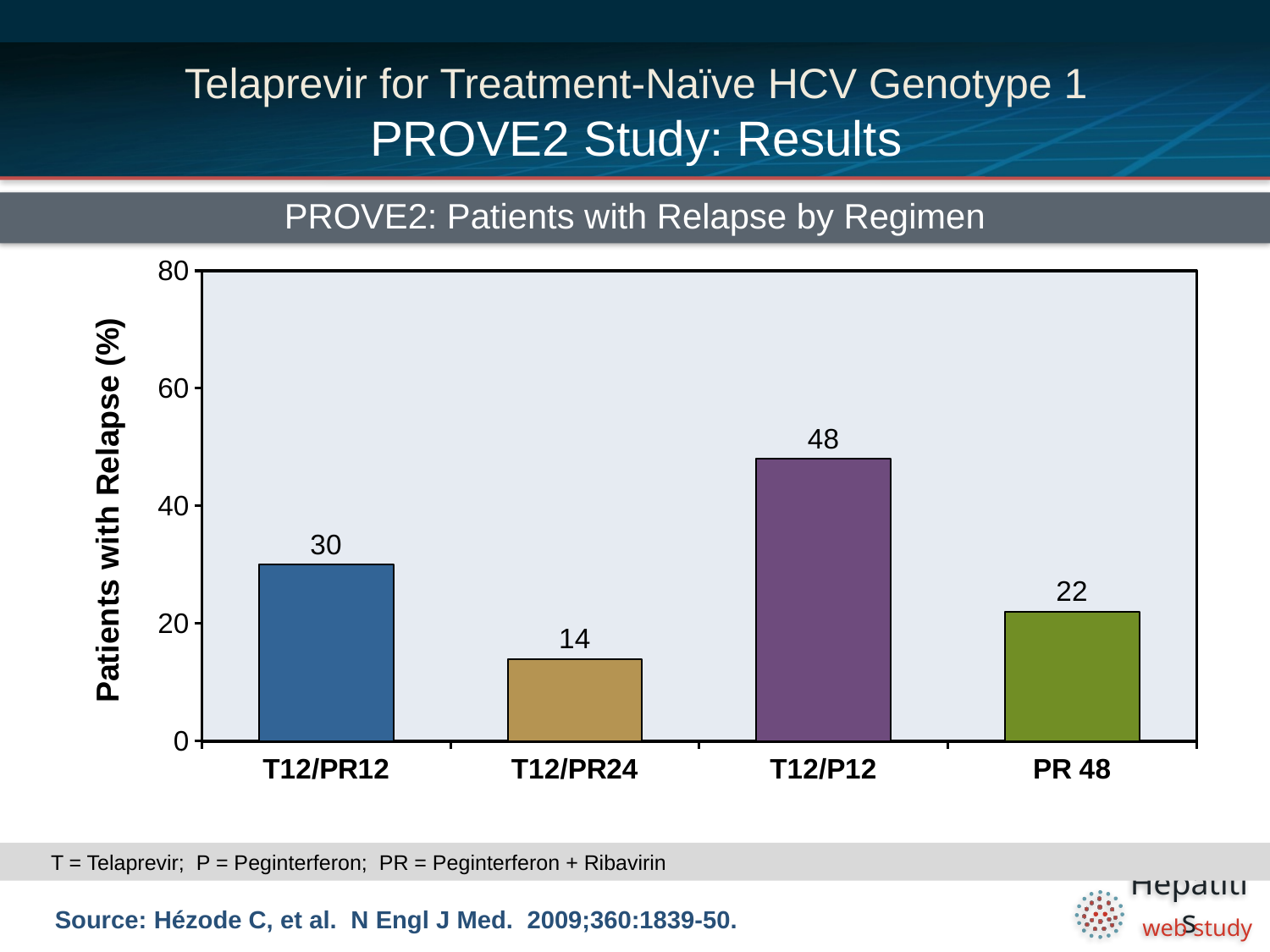
What is the title of the chart? PROVE2: Patients with Relapse by Regimen What is the percentage of patients with relapse for the PR 48 regimen? 22 Is the relapse value for T12/P12 greater or less than 40? greater What is the difference in relapse percentage between T12/P12 and T12/PR24? 34 What type of chart is shown on the slide? Bar chart Which regimen has a higher relapse percentage, T12/PR12 or PR 48? T12/PR12 What is the percentage of patients with relapse for the T12/PR12 regimen? 30 How many regimens are shown in the chart? 4 Which regimen has the highest percentage of patients with relapse? T12/P12 What is the percentage of patients with relapse for the T12/PR24 regimen? 14 What is the percentage of patients with relapse for the T12/P12 regimen? 48 Which regimen has the lowest percentage of patients with relapse? T12/PR24